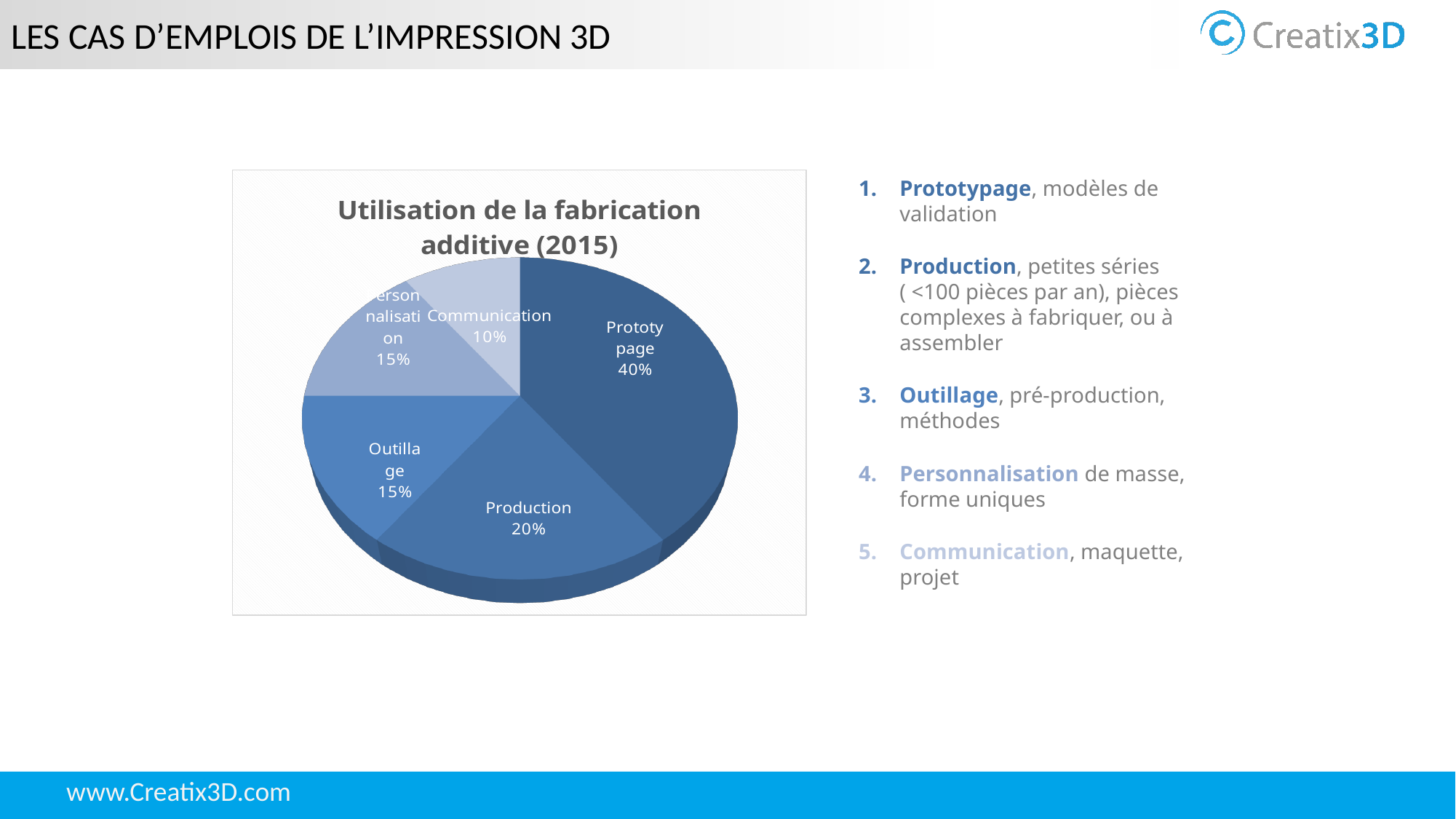
How many slices does the pie chart have? 5 Which category has the largest share of the pie? Prototypage What percentage does the Outillage slice represent? 15% Which category has the smallest share of the pie? Communication What percentage does the Communication slice represent? 10% What is the difference in percentage points between Prototypage and Production? 20 What is the title of the chart? Utilisation de la fabrication additive (2015) Which is larger, the Production slice or the Communication slice? Production What is the combined share of Outillage and Personnalisation? 30% What percentage does the Prototypage slice represent? 40% What percentage does the Production slice represent? 20% What type of chart is shown on the slide? Pie chart